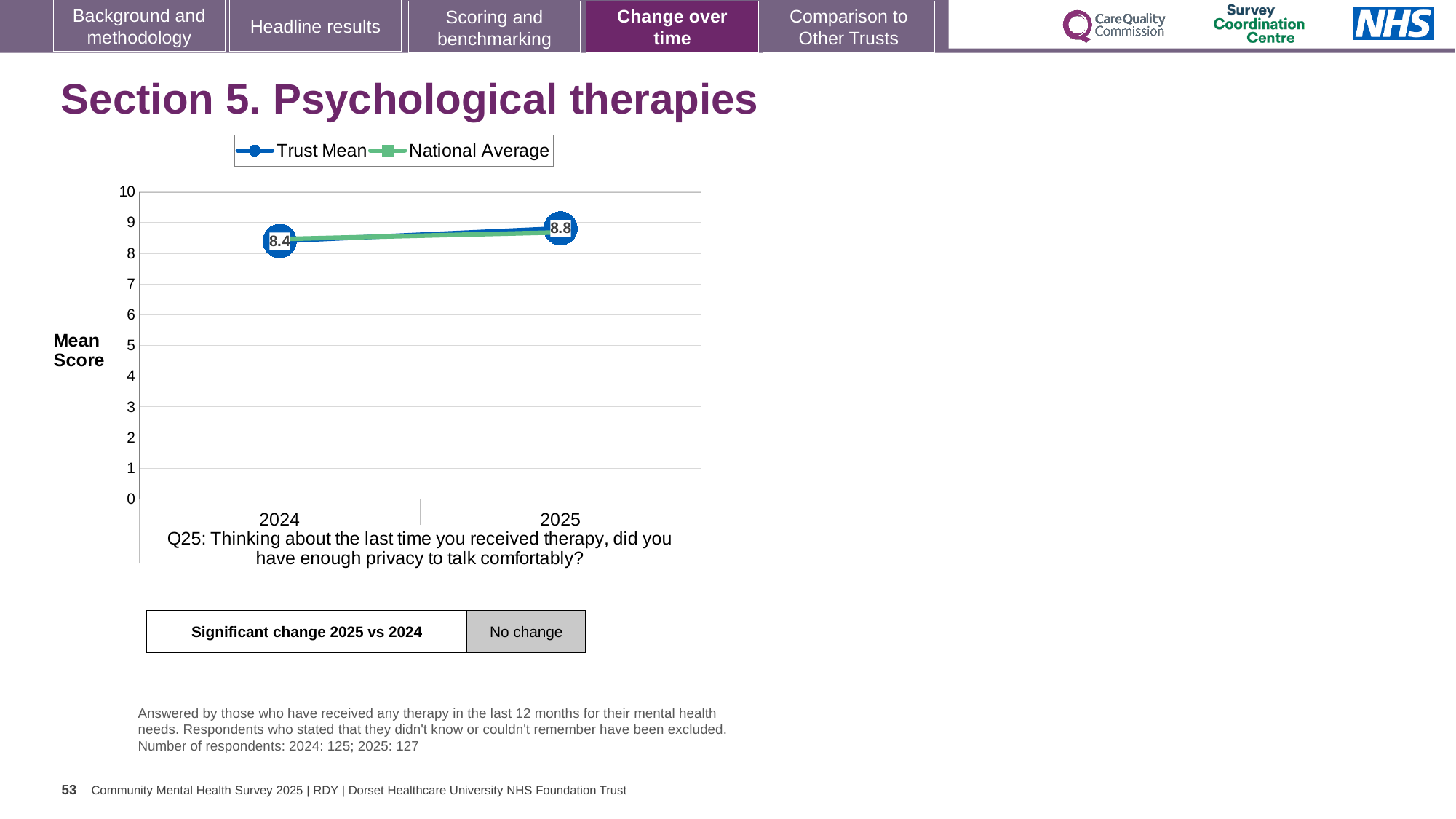
Is the National Average value for 2025 greater or less than 8? greater What is the Trust Mean score for 2025? 8.8 What kind of chart is shown on the slide? line chart Which year has the higher Trust Mean score? 2025 Which year has the lower Trust Mean score? 2024 What does the box labelled 'Significant change 2025 vs 2024' say? No change How many series does the chart legend list? 2 What is the Trust Mean score for 2024? 8.4 Is the Trust Mean for 2025 larger or smaller than the Trust Mean for 2024? larger By how much did the Trust Mean change from 2024 to 2025? 0.4 How many years are shown on the x axis of the chart? 2 Does the Trust Mean rise or fall from 2024 to 2025? rise